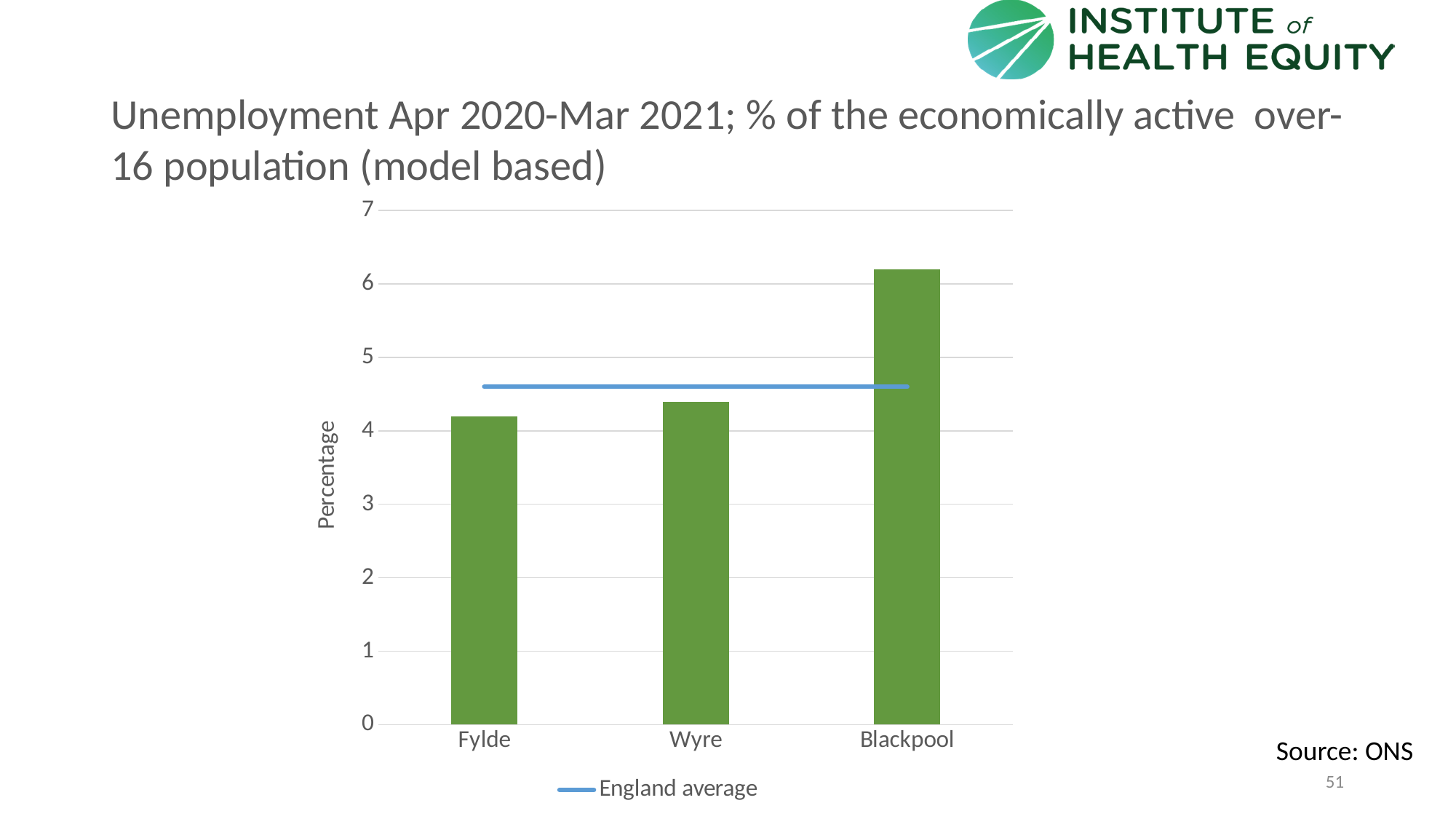
Which area has the highest unemployment rate in the chart? Blackpool Is the value for Wyre greater or less than 4? greater Is the value for Blackpool greater or less than 5? greater How many local areas are shown on the x axis of the chart? 3 Which has the higher unemployment rate, Fylde or Wyre? Wyre Which area has the lowest unemployment rate in the chart? Fylde Is the value for Fylde greater or less than 5? less What is the label on the vertical axis of the chart? Percentage What kind of chart is shown on the slide? combination bar and line chart How many entries does the chart's legend list? 1 Which has the higher unemployment rate, Wyre or Blackpool? Blackpool